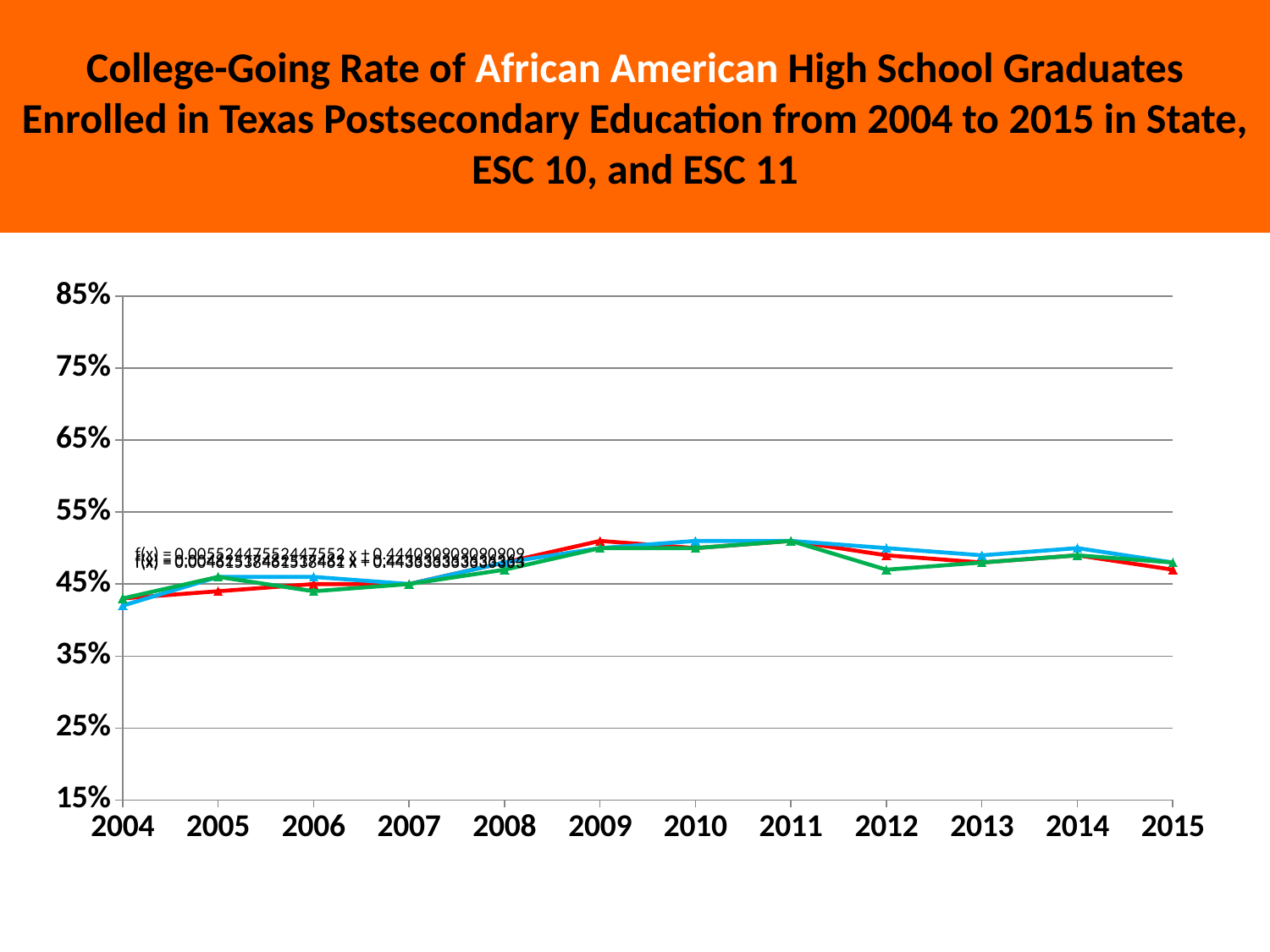
Which year has the lowest college-going rate for all three lines on the chart? 2004 Are the values for 2011 greater or less than 45%? greater Are the values for 2015 greater or less than 35%? greater How many years are plotted along the x axis of the chart? 12 Are the values for 2009 greater or less than 55%? less How many lines are plotted on the chart? 3 Do the lines rise or fall from 2011 to 2015? fall Which three regions does the chart title say the college-going rates are for? State, ESC 10, and ESC 11 Do the lines generally rise or fall from 2004 to 2011? rise What is the highest value shown on the y axis of the chart? 85% What kind of chart is shown on the slide? line chart